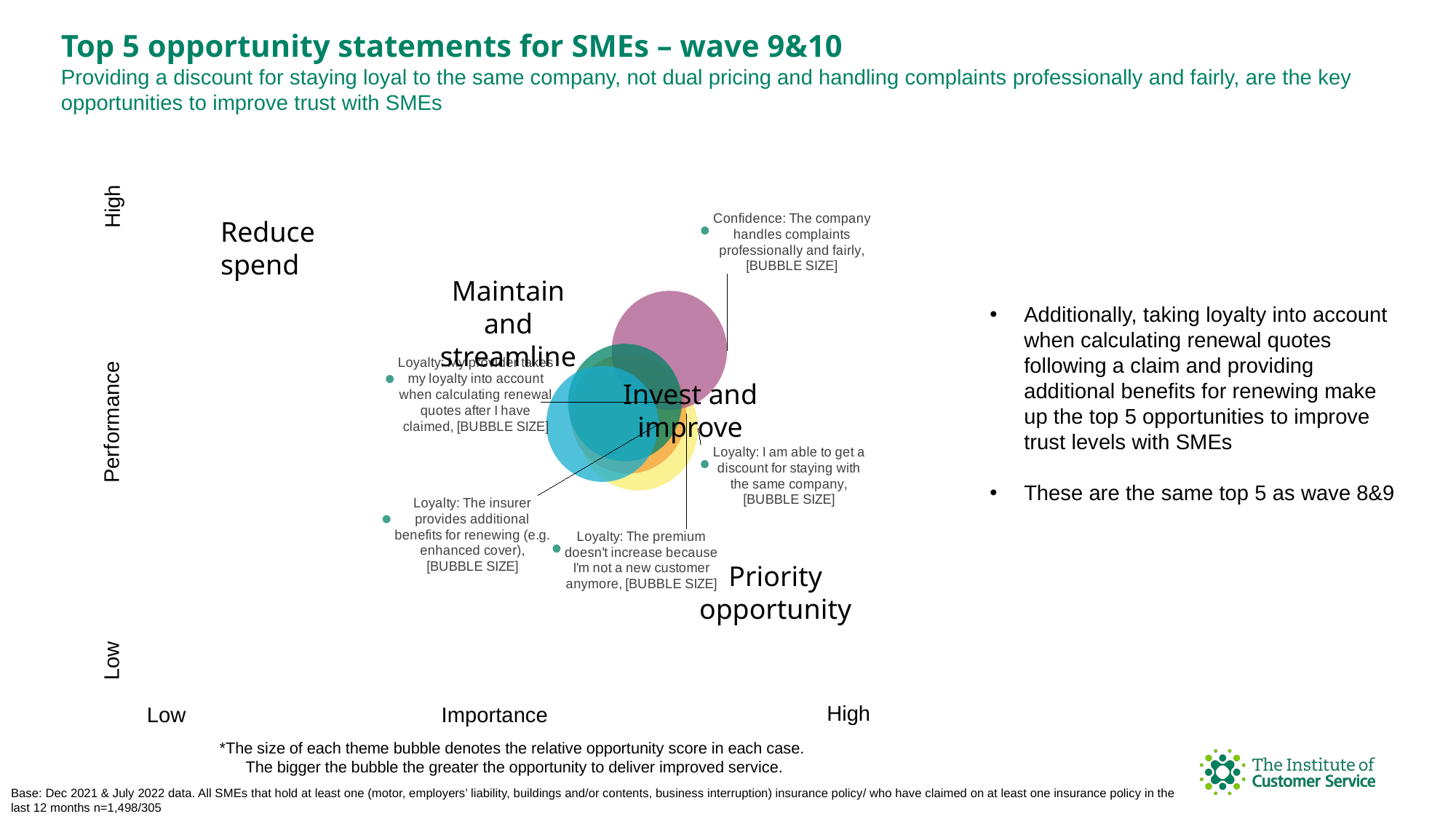
What is the label of the horizontal axis of the chart? Importance What kind of chart is shown on the slide? Bubble chart Which opportunity statement's bubble sits highest on the Performance axis? Confidence: The company handles complaints professionally and fairly Which bubble is positioned further to the left on the Importance axis: 'Loyalty: The insurer provides additional benefits for renewing' or 'Confidence: The company handles complaints professionally and fairly'? Loyalty: The insurer provides additional benefits for renewing What quadrant label appears in the bottom-right area of the chart? Priority opportunity Which bubble is higher on the Performance axis: 'Confidence: The company handles complaints professionally and fairly' or 'Loyalty: The premium doesn't increase because I'm not a new customer anymore'? Confidence: The company handles complaints professionally and fairly How many opportunity statements are plotted as bubbles on the chart? 5